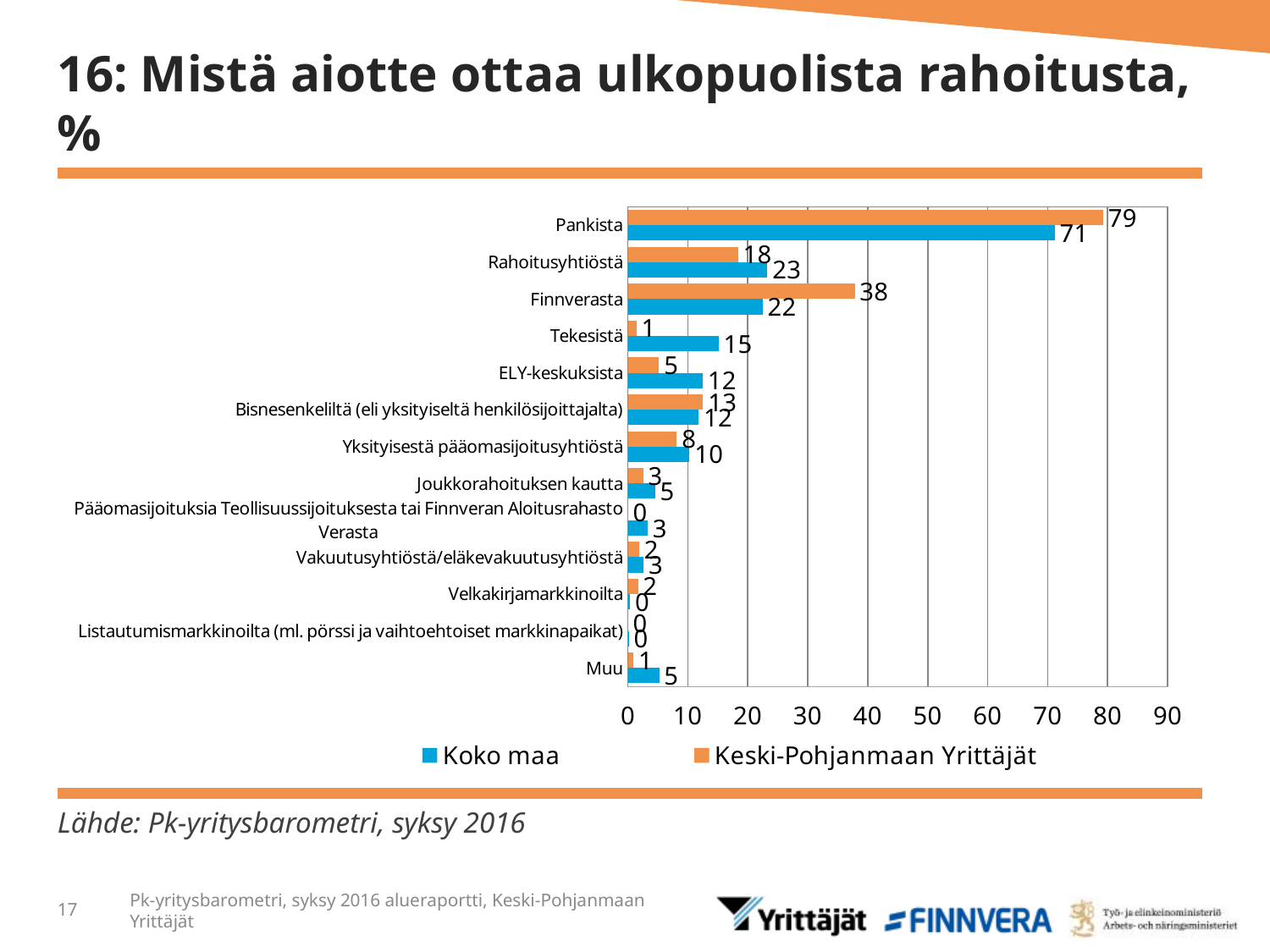
What is the difference between the Keski-Pohjanmaan Yrittäjät and Koko maa values for Finnverasta? 16 What is the value for Pankista in the Keski-Pohjanmaan Yrittäjät series? 79 Which colour represents the Keski-Pohjanmaan Yrittäjät series? orange What is the value for Tekesistä in the Koko maa series? 15 What kind of chart is shown on the slide? bar chart What is the value for Pankista in the Koko maa series? 71 How many categories are shown on the chart? 13 Which category has the highest value in the Koko maa series? Pankista How many series does the legend list? 2 What is the value for Finnverasta in the Keski-Pohjanmaan Yrittäjät series? 38 Is the Koko maa value for Pankista greater or less than 60? greater Which is larger for Rahoitusyhtiöstä: the Koko maa value or the Keski-Pohjanmaan Yrittäjät value? Koko maa